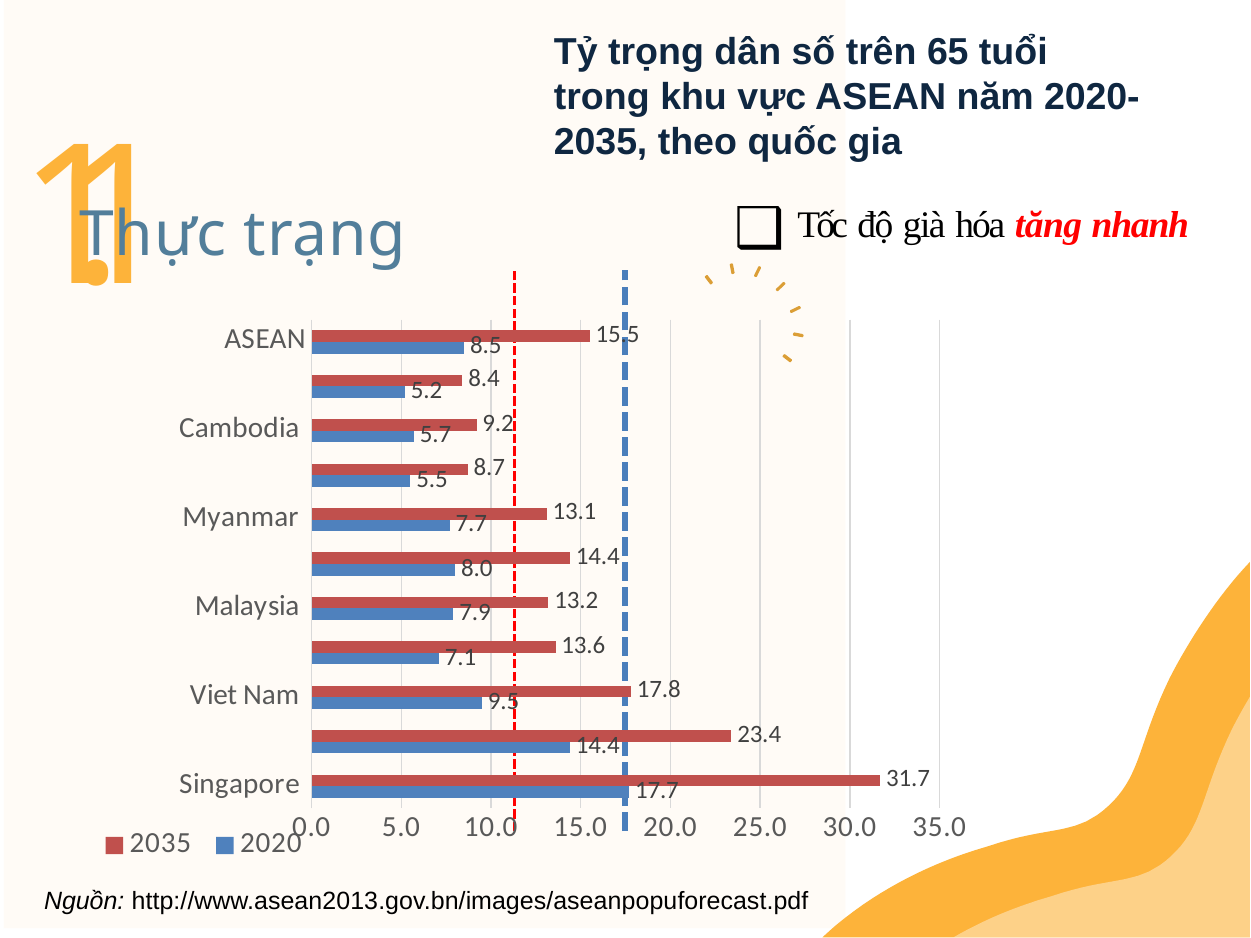
What is the 2020 value for Viet Nam? 9.5 What is the 2035 value for Singapore? 31.7 Which labeled country has the highest 2035 value? Singapore Is the 2035 value for Singapore greater or less than 30.0? greater What is the difference between the 2035 and 2020 values for Singapore? 14.0 What is the difference between the 2035 and 2020 values for Viet Nam? 8.3 Which colour represents the 2020 series in the legend? blue What is the 2035 value for ASEAN? 15.5 What kind of chart is shown on the slide? bar chart How many series does the legend list? 2 Which is larger, the 2020 value for Viet Nam or the 2020 value for Malaysia? Viet Nam What is the 2020 value for Cambodia? 5.7